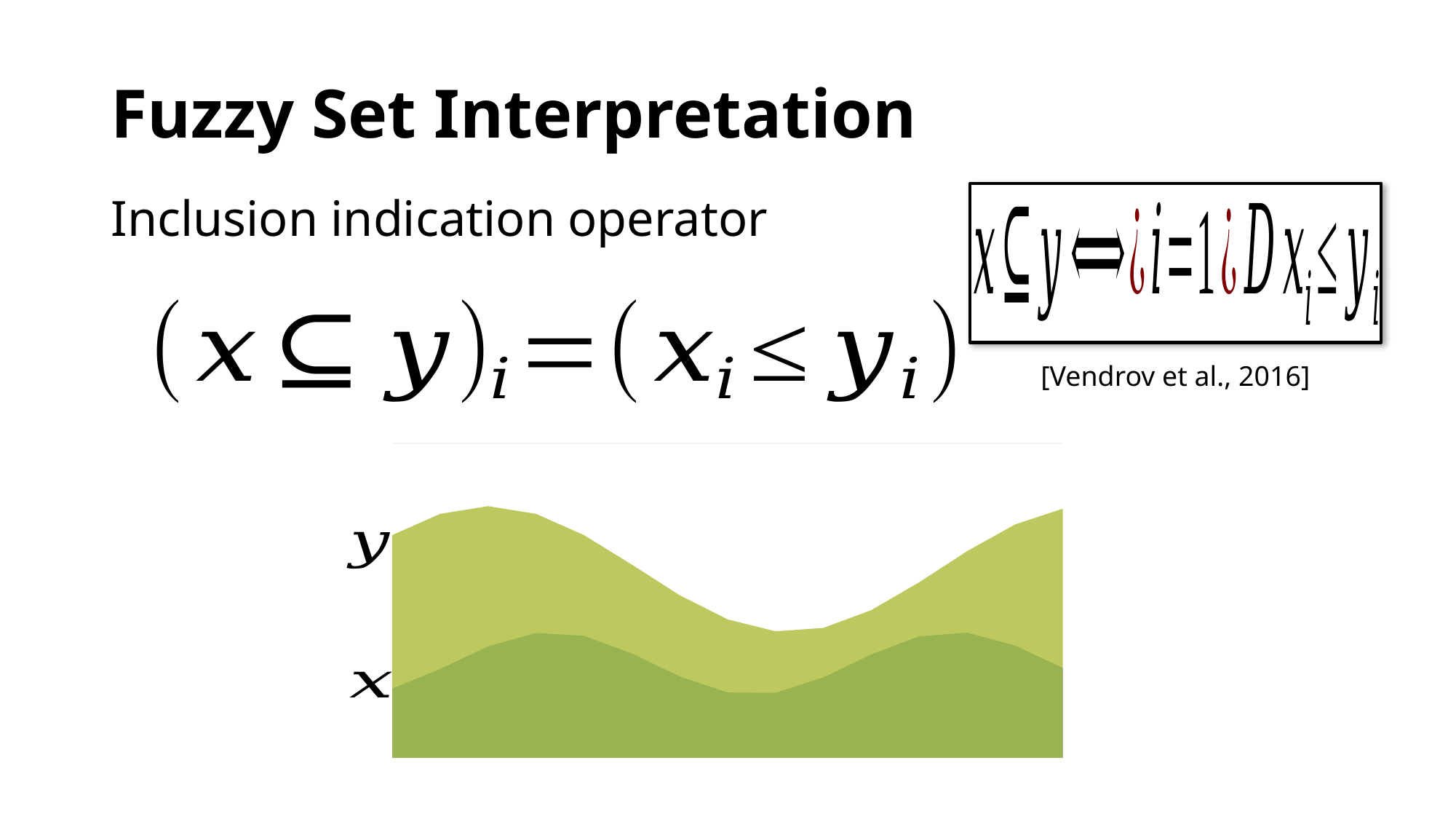
How many series are plotted in the area chart? 2 Which series in the area chart is drawn in the darker green colour? x What kind of chart is shown at the bottom of the slide? area chart Which series in the area chart has the lower values throughout? x What are the two series in the area chart labelled? y and x Which series in the area chart is plotted higher across the whole chart, x or y? y